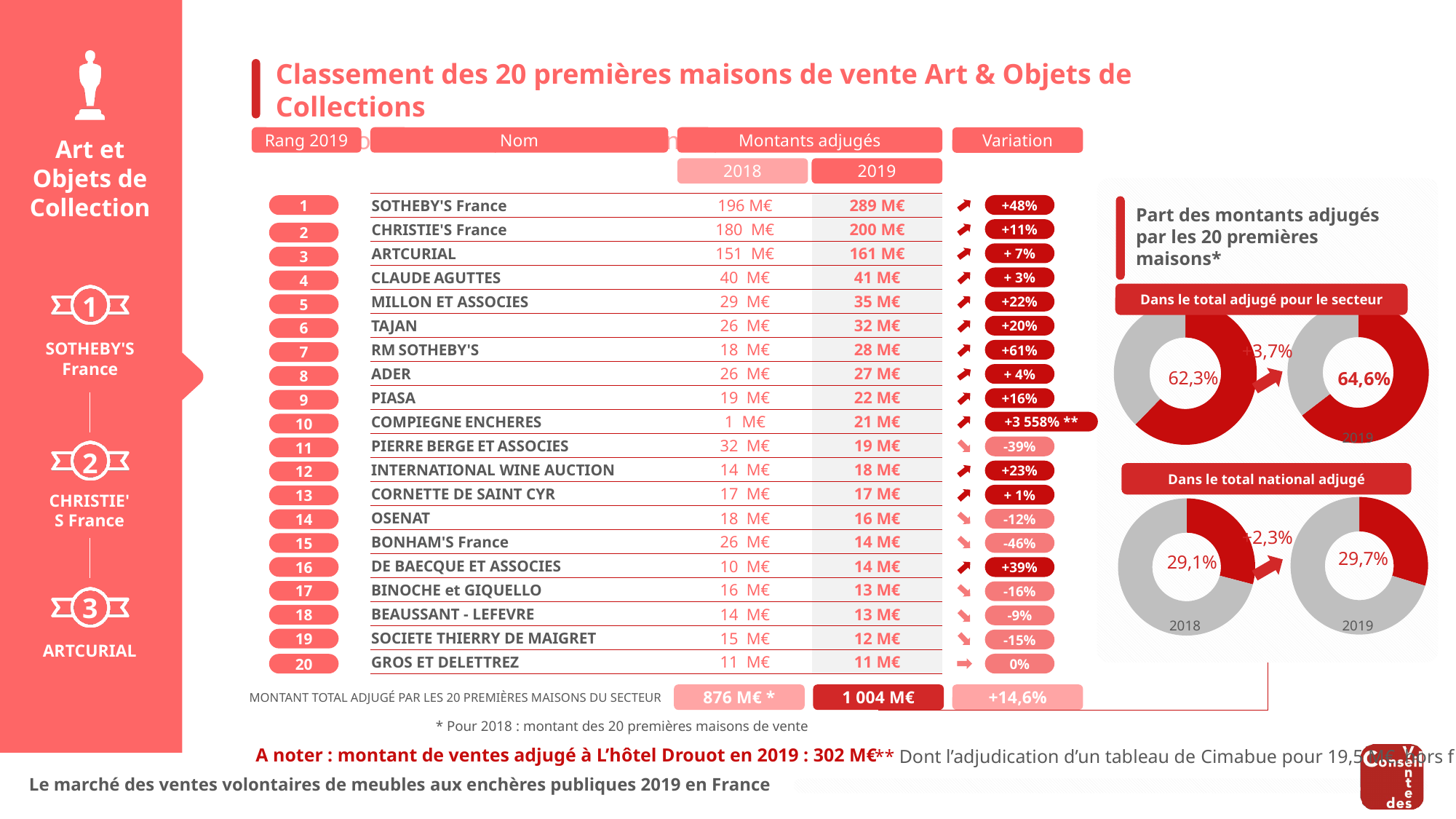
In the 'Dans le total adjugé pour le secteur' charts, what share is shown for 2018? 62,3% Does the share of the 20 first houses in the sector total rise or fall from 2018 to 2019? Rise In the 'Dans le total national adjugé' charts, what share is shown for 2019? 29,7% In the 'Dans le total national adjugé' charts, what share is shown for 2018? 29,1% In the 'Dans le total adjugé pour le secteur' charts, by how many percentage points does the share change from 2018 to 2019? +2,3% In the 'Dans le total adjugé pour le secteur' charts, which year shows the larger share, 2018 or 2019? 2019 How many donut charts are shown on the right side of the slide? 4 What is the title of the section containing the donut charts? Part des montants adjugés par les 20 premières maisons* In the 'Dans le total national adjugé' charts, what change is printed between the 2018 and 2019 donuts? +2,3% In the 'Dans le total national adjugé' charts, which year shows the larger share, 2018 or 2019? 2019 What kind of chart is used to show the 'Part des montants adjugés par les 20 premières maisons'? Donut (pie) chart In the 'Dans le total adjugé pour le secteur' charts, what share is shown for 2019? 64,6%